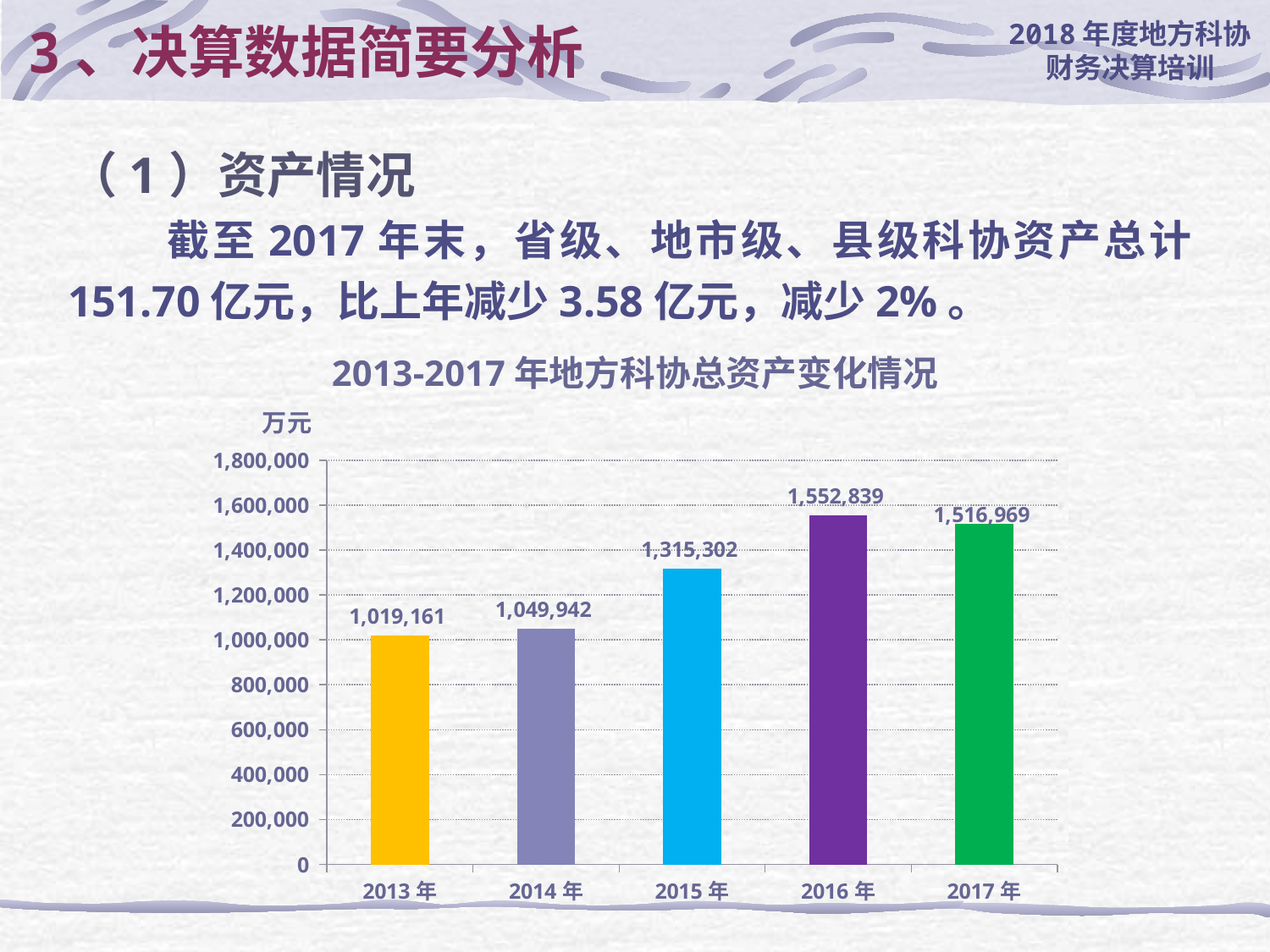
What unit is shown on the y axis of the chart? 万元 Is the value for 2015年 greater or less than 1,400,000? less Which year has the highest total assets in the chart? 2016年 What is the difference between the values for 2016年 and 2017年? 35,870 What is the value for 2017年 in the chart? 1,516,969 What is the value for 2016年 in the chart? 1,552,839 Which year has the lowest total assets in the chart? 2013年 Which is larger, the value for 2015年 or the value for 2014年? 2015年 What is the difference between the values for 2014年 and 2013年? 30,781 What kind of chart is shown on the slide? bar chart What is the value for 2013年 in the chart? 1,019,161 How many years are shown on the x axis of the chart? 5